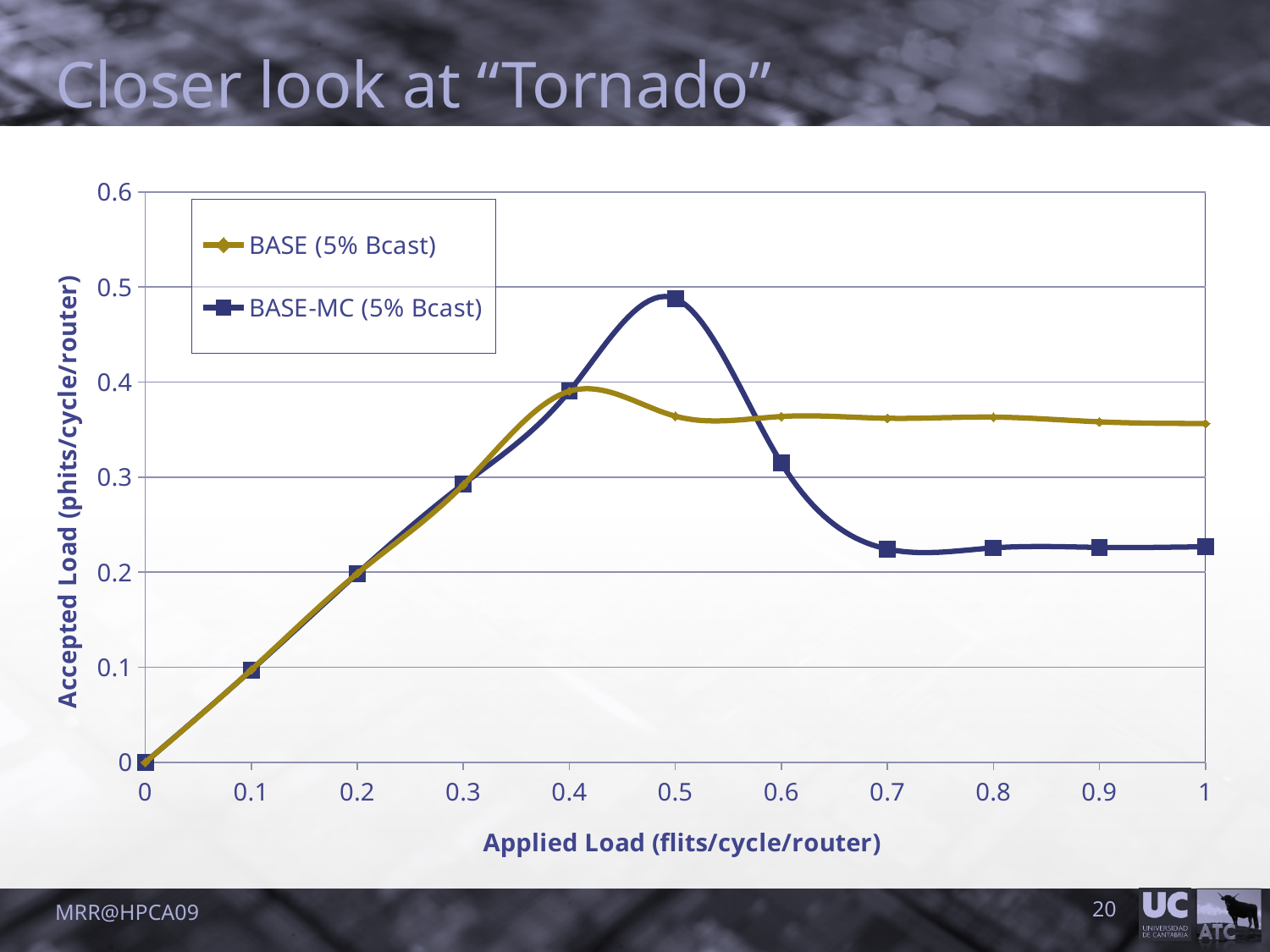
At an applied load of 0.8, which series has the higher accepted load? BASE (5% Bcast) Is the value for BASE (5% Bcast) at an applied load of 1 greater or less than 0.3? greater How many data points are plotted for the BASE-MC (5% Bcast) series? 11 Is the value for BASE-MC (5% Bcast) at an applied load of 0.7 greater or less than 0.3? less How many series does the legend list? 2 Does the BASE-MC (5% Bcast) series rise or fall between applied loads of 0.5 and 0.7? fall At which applied load does the BASE-MC (5% Bcast) series reach its highest accepted load? 0.5 What kind of chart is shown on the slide? line chart Is the value for BASE-MC (5% Bcast) at an applied load of 0.5 greater or less than 0.4? greater What is the title of the x axis? Applied Load (flits/cycle/router) At an applied load of 0.5, which series has the higher accepted load? BASE-MC (5% Bcast)